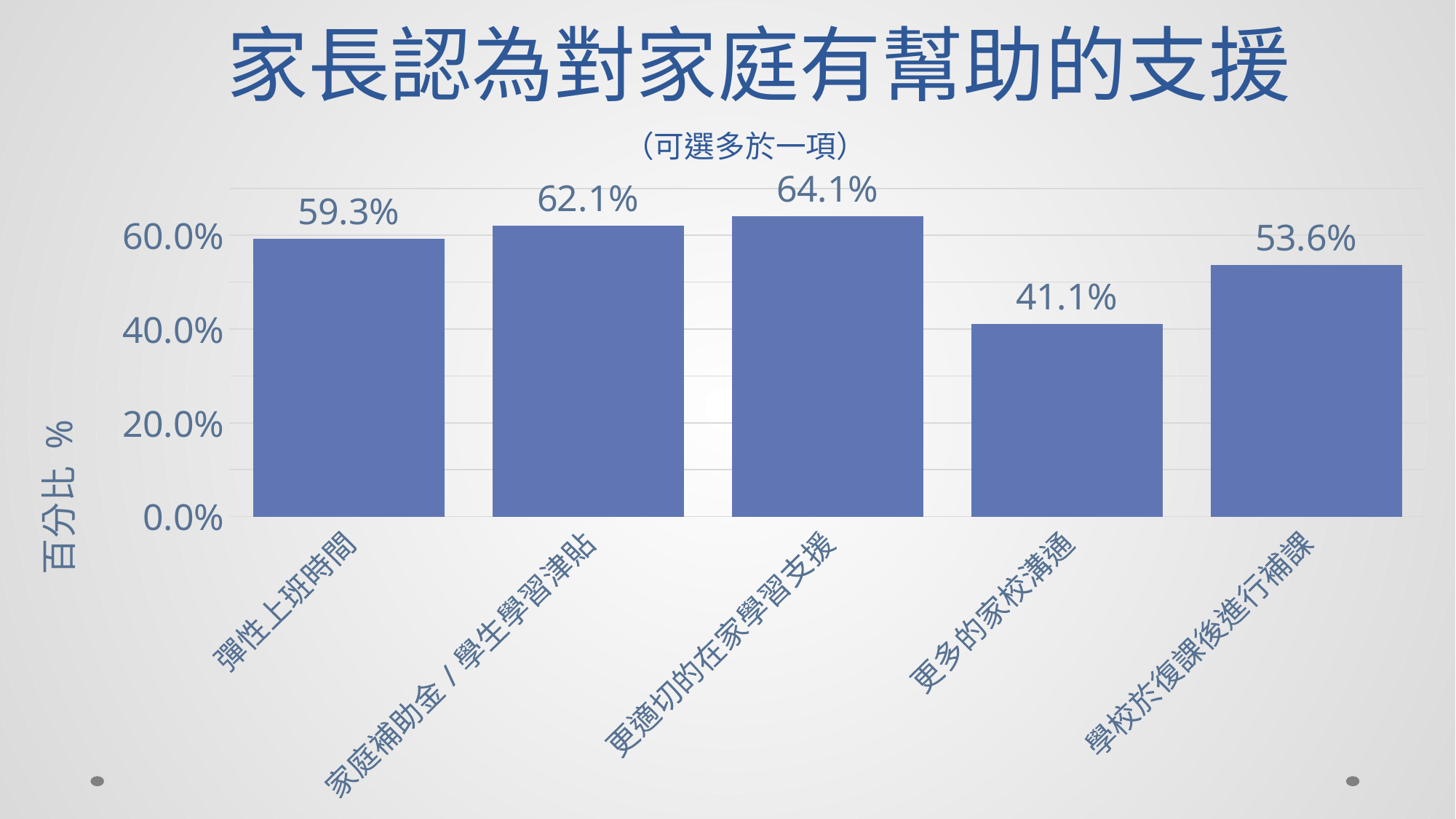
What is the value for 彈性上班時間? 59.3% Which is larger, the value for 彈性上班時間 or the value for 學校於復課後進行補課? 彈性上班時間 How many categories are shown in the chart? 5 Which category has the lowest value? 更多的家校溝通 What is the value for 家庭補助金 / 學生學習津貼? 62.1% What is the value for 更多的家校溝通? 41.1% What is the value for 學校於復課後進行補課? 53.6% What is the difference between the values for 更適切的在家學習支援 and 更多的家校溝通? 23.0% What is the value for 更適切的在家學習支援? 64.1% What kind of chart is shown on the slide? Bar chart Which category has the highest value? 更適切的在家學習支援 What is the title of the chart? 家長認為對家庭有幫助的支援